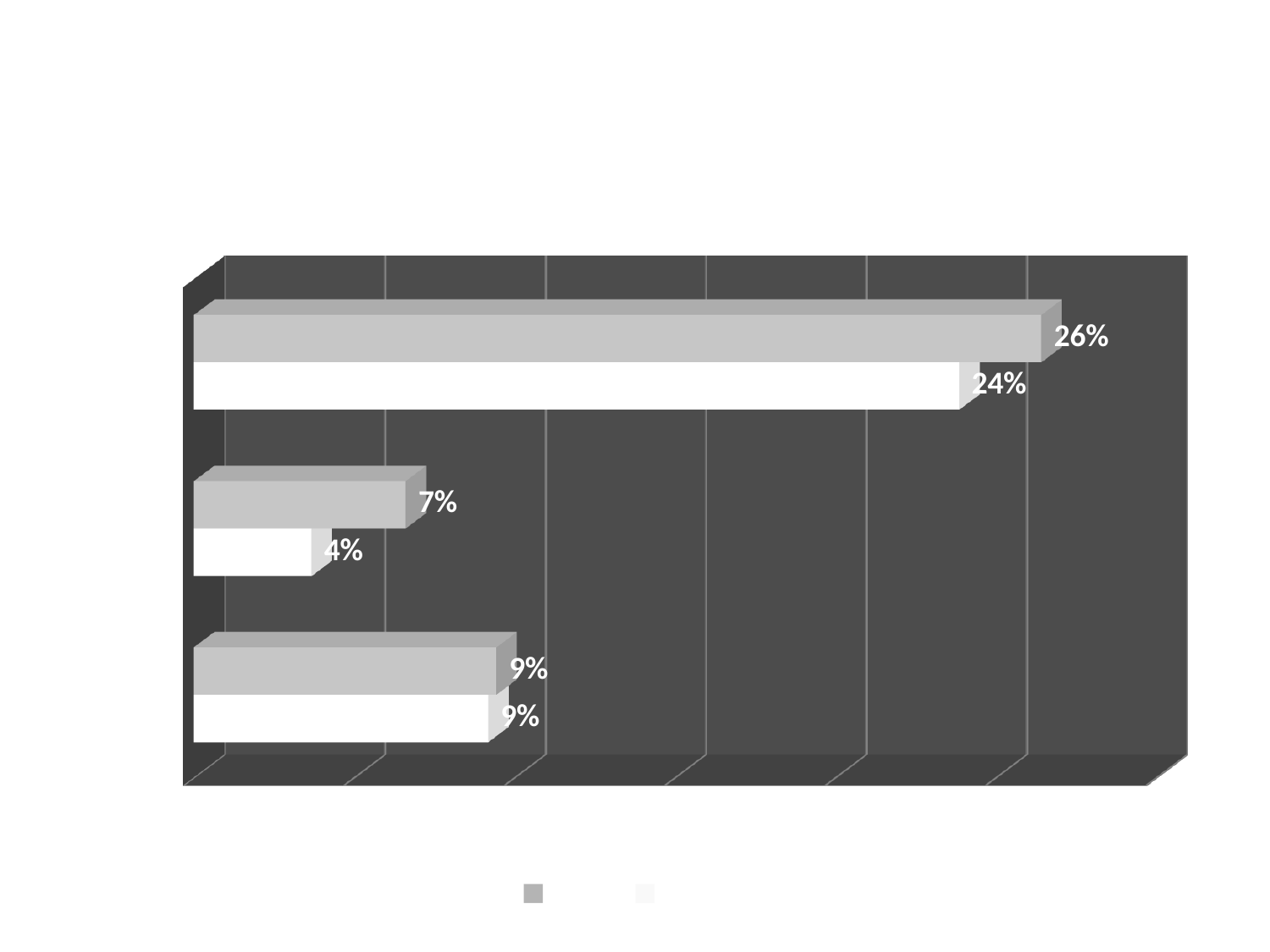
What is the lowest value shown on the chart? 4% What is the value of the white bar in the bottom group? 9% How many groups of bars (categories) does the chart show? 3 What is the difference between the grey bar and the white bar in the top group? 2 percentage points What is the value of the white bar in the middle group? 4% What is the highest value shown on the chart? 26% How many series does the legend list? 2 In the middle group, which bar is larger, the grey bar or the white bar? The grey bar What is the value of the white bar in the top group? 24% What kind of chart is shown on the slide? Bar chart What is the value of the grey bar in the top group? 26% What is the value of the grey bar in the middle group? 7%